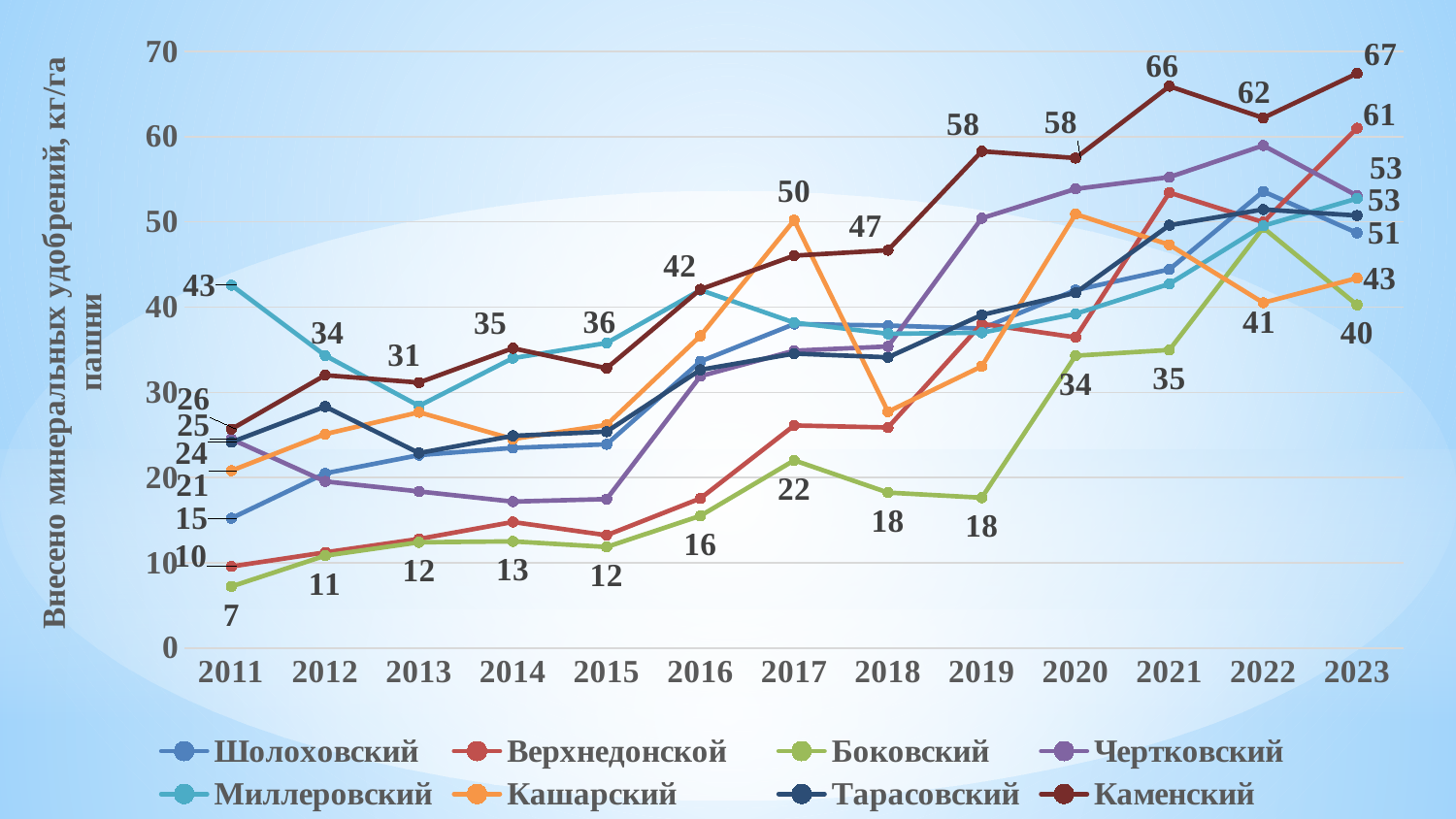
What is the value for Кашарский in 2017? 50 What is the value for Верхнедонской in 2023? 61 How many years are shown on the x axis? 13 What is the value for Каменский in 2023? 67 Is the value for Чертковский in 2022 greater or less than 50? greater Which series has the highest value in 2023? Каменский Which series has the lowest value in 2011? Боковский What is the value for Каменский in 2021? 66 How many series does the legend list? 8 By how much did the value for Каменский change from 2022 to 2023? 5 What kind of chart is shown on the slide? line chart What is the value for Боковский in 2011? 7